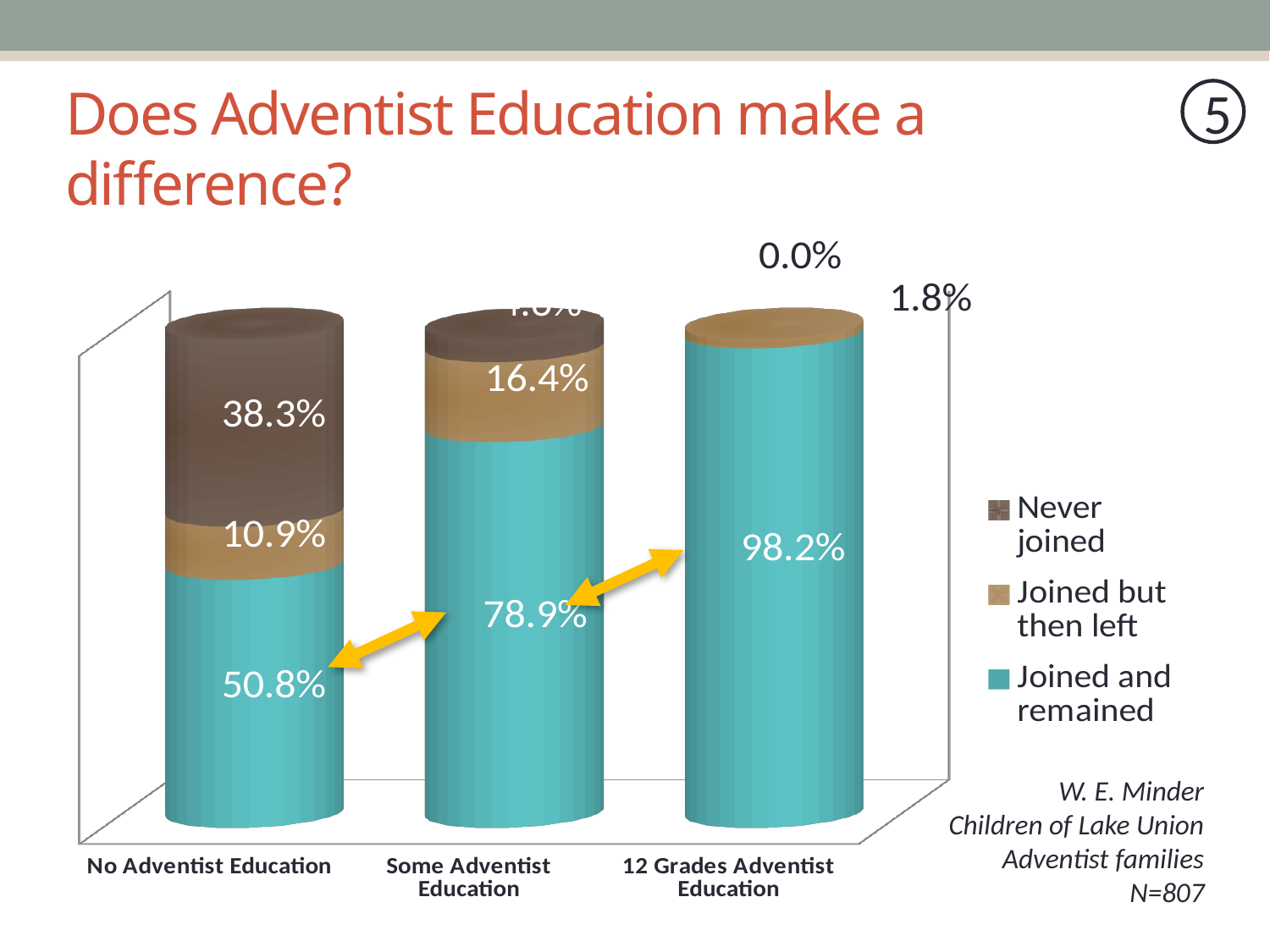
Which education category has the lowest 'Joined and remained' percentage? No Adventist Education What is the 'Joined and remained' value for 12 Grades Adventist Education? 98.2% What is the 'Joined but then left' value for Some Adventist Education? 16.4% How many series does the legend list? 3 How many education categories are shown on the x axis? 3 Which education category has the highest 'Joined and remained' percentage? 12 Grades Adventist Education What is the 'Never joined' value for 12 Grades Adventist Education? 0.0% What percentage of those with No Adventist Education 'Joined and remained'? 50.8% What kind of chart is shown on the slide? Stacked bar chart What is the 'Never joined' value for No Adventist Education? 38.3% What is the difference in 'Joined and remained' between 12 Grades Adventist Education and No Adventist Education? 47.4 percentage points Is the 'Joined but then left' value larger for No Adventist Education or for Some Adventist Education? Some Adventist Education